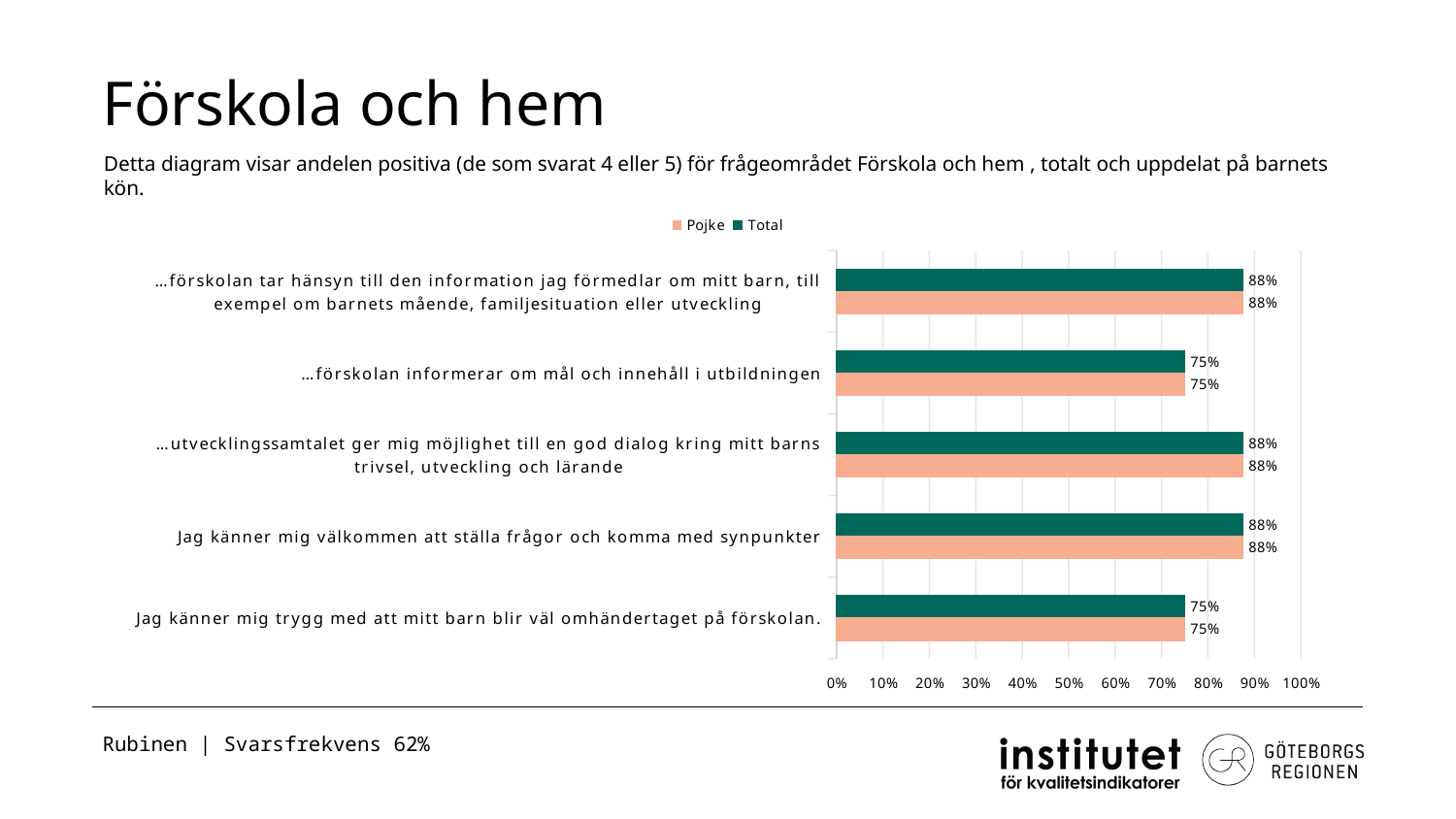
Is the Pojke value for "…förskolan informerar om mål och innehåll i utbildningen" greater or less than 80%? less How many series does the chart legend list? 2 What is the highest value shown on the chart's x axis? 100% Which series is shown in green in the chart? Total Which is larger: the Total value for "Jag känner mig välkommen att ställa frågor och komma med synpunkter" or the Total value for "Jag känner mig trygg med att mitt barn blir väl omhändertaget på förskolan."? Jag känner mig välkommen att ställa frågor och komma med synpunkter What is the difference between the Total values for "…förskolan tar hänsyn till den information jag förmedlar om mitt barn..." and "…förskolan informerar om mål och innehåll i utbildningen"? 13% What is the Total value for "…förskolan informerar om mål och innehåll i utbildningen"? 75% What kind of chart is shown on the slide? bar chart How many categories (statements) are plotted in the chart? 5 What is the Pojke value for "…utvecklingssamtalet ger mig möjlighet till en god dialog kring mitt barns trivsel, utveckling och lärande"? 88% What is the Total value for "Jag känner mig trygg med att mitt barn blir väl omhändertaget på förskolan."? 75% What is the Pojke value for "Jag känner mig välkommen att ställa frågor och komma med synpunkter"? 88%